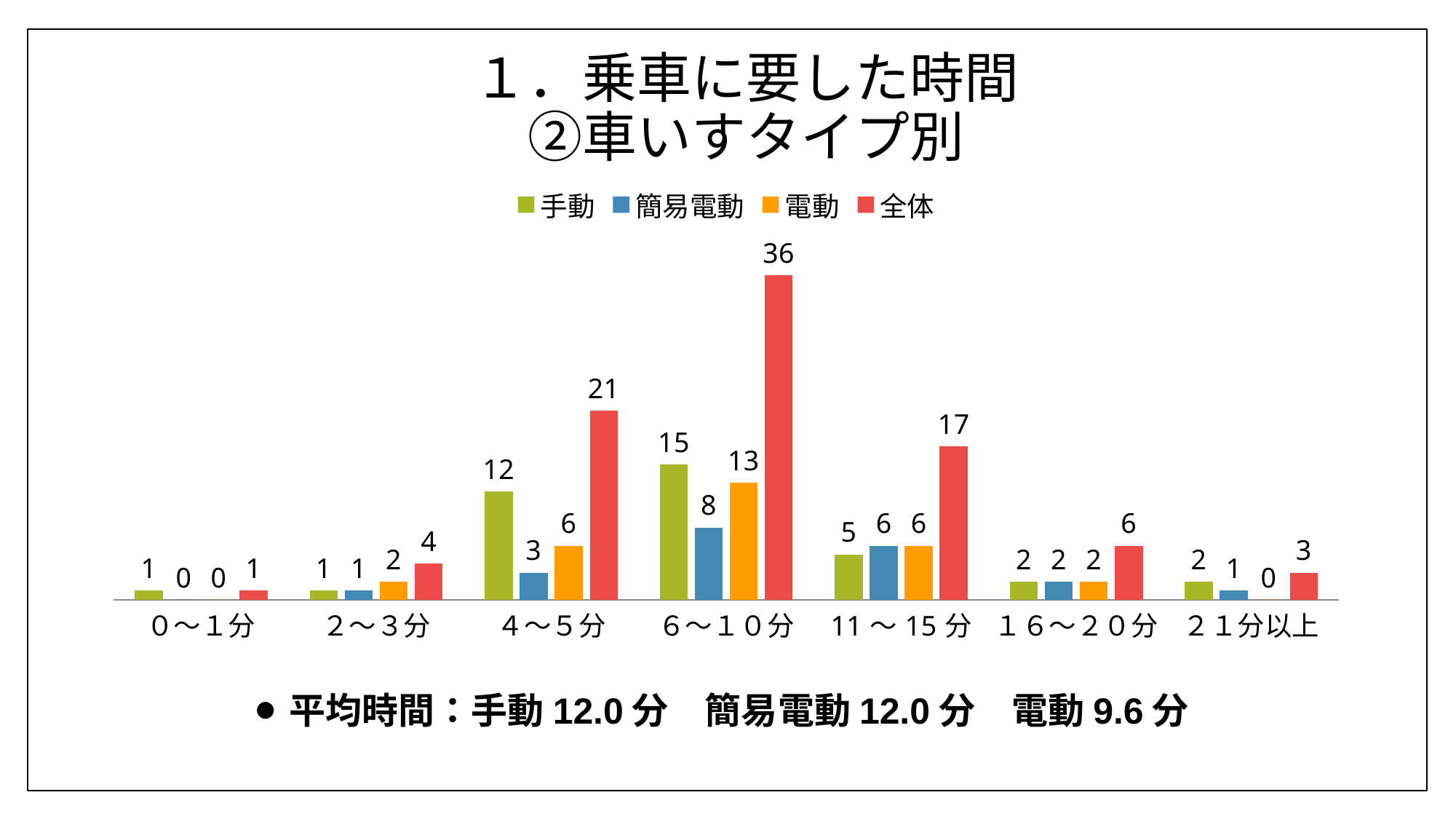
Which category has the lowest value for 手動? ０～１分 and ２～３分 (both 1) What is the difference between the 全体 values for ６～１０分 and ４～５分? 15 How many categories are shown on the x axis? 7 How many series does the legend list? 4 Which category has the highest value for 全体? ６～１０分 What is the value for 電動 in the ６～１０分 category? 13 What kind of chart is shown on the slide? Bar chart Which series is shown in red in the legend? 全体 What is the value for 全体 in the ６～１０分 category? 36 What is the value for 簡易電動 in the ２１分以上 category? 1 Which is larger: the 手動 value for ６～１０分 or the 電動 value for ６～１０分? 手動 (15) What is the value for 手動 in the ４～５分 category? 12